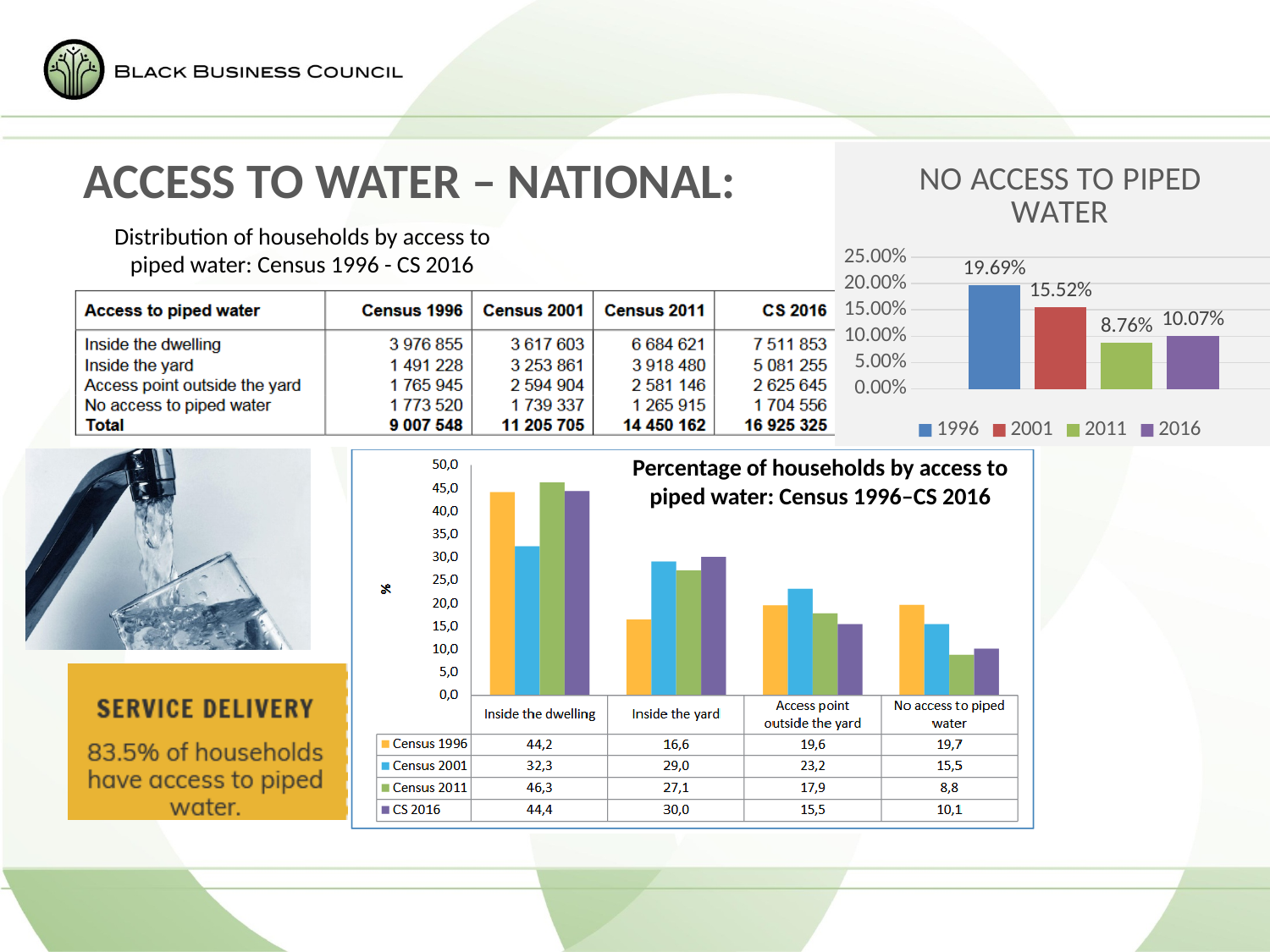
In the 'NO ACCESS TO PIPED WATER' chart, which year has the lowest value? 2011 In the 'NO ACCESS TO PIPED WATER' chart, how many series does the legend list? 4 In the 'NO ACCESS TO PIPED WATER' chart, which year has the highest value? 1996 In the 'Percentage of households by access to piped water' chart, which is larger for No access to piped water: Census 1996 or CS 2016? Census 1996 In the 'Percentage of households by access to piped water' chart, which series has the highest value for Access point outside the yard? Census 2001 What kind of chart is the 'NO ACCESS TO PIPED WATER' chart? Bar chart In the 'NO ACCESS TO PIPED WATER' chart, what is the value for 1996? 19.69% In the 'NO ACCESS TO PIPED WATER' chart, what is the difference between the 2016 value and the 2011 value? 1.31% In the 'Percentage of households by access to piped water' chart, what is the Census 2011 value for Inside the dwelling? 46,3 In the 'NO ACCESS TO PIPED WATER' chart, is the value for 2001 greater or less than 15.00%? greater In the 'Percentage of households by access to piped water' chart, what is the CS 2016 value for Inside the yard? 30,0 In the 'Percentage of households by access to piped water' chart, how many categories are shown on the x axis? 4